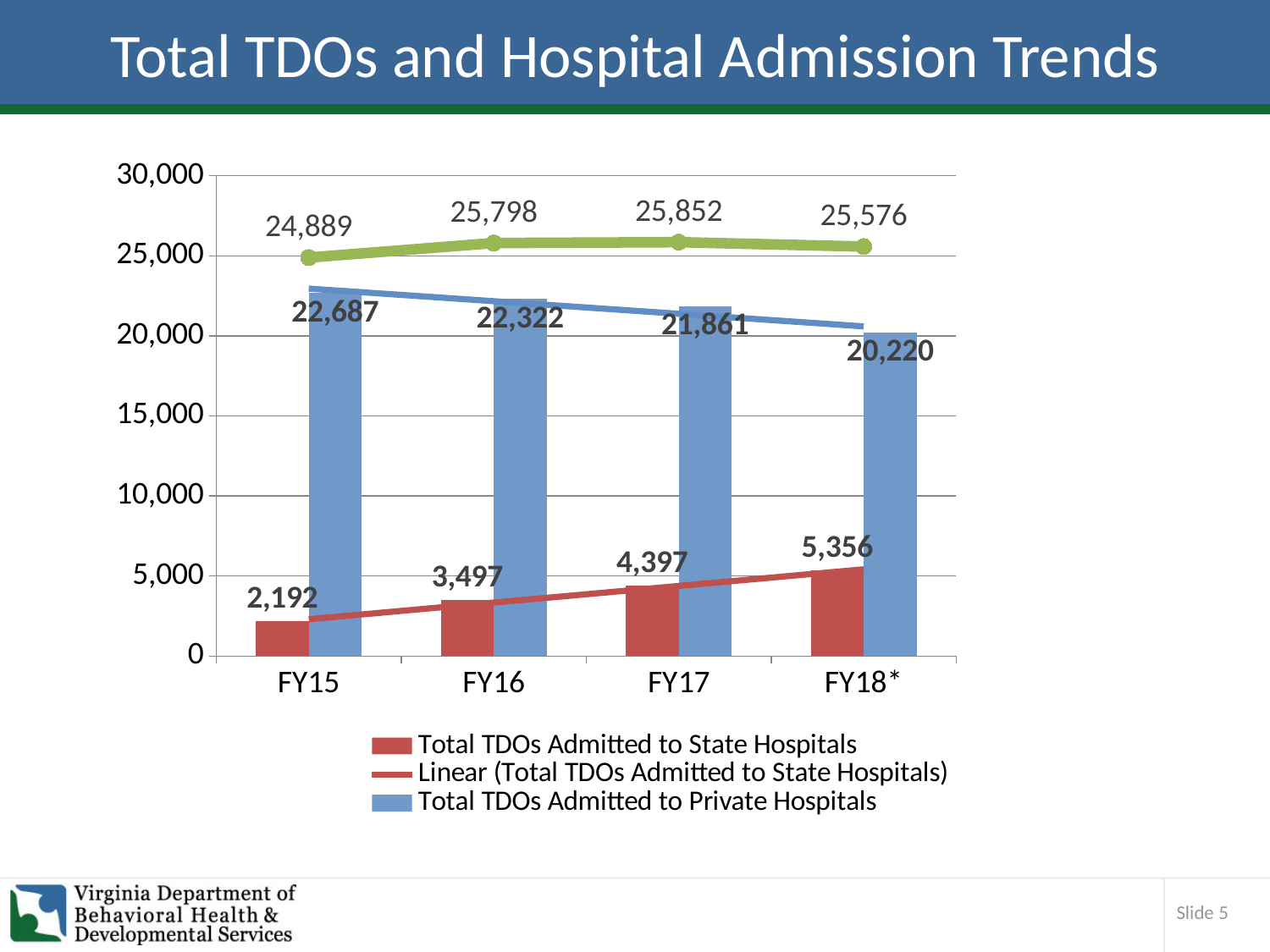
In which fiscal year is Total TDOs Admitted to State Hospitals highest? FY18* How many entries does the legend list? 3 In which fiscal year is Total TDOs Admitted to Private Hospitals lowest? FY18* What is the value for Total TDOs Admitted to Private Hospitals in FY16? 22,322 What is the difference between Total TDOs Admitted to State Hospitals in FY18* and FY15? 3,164 What is the difference between Total TDOs Admitted to Private Hospitals in FY15 and FY18*? 2,467 What is the value for Total TDOs Admitted to State Hospitals in FY17? 4,397 Which is larger: Total TDOs Admitted to State Hospitals in FY16 or in FY17? FY17 How many fiscal years are shown on the x axis? 4 What is the value for Total TDOs Admitted to Private Hospitals in FY18*? 20,220 What is the value for Total TDOs Admitted to State Hospitals in FY15? 2,192 Do the values for Total TDOs Admitted to State Hospitals rise or fall from FY15 to FY18*? rise